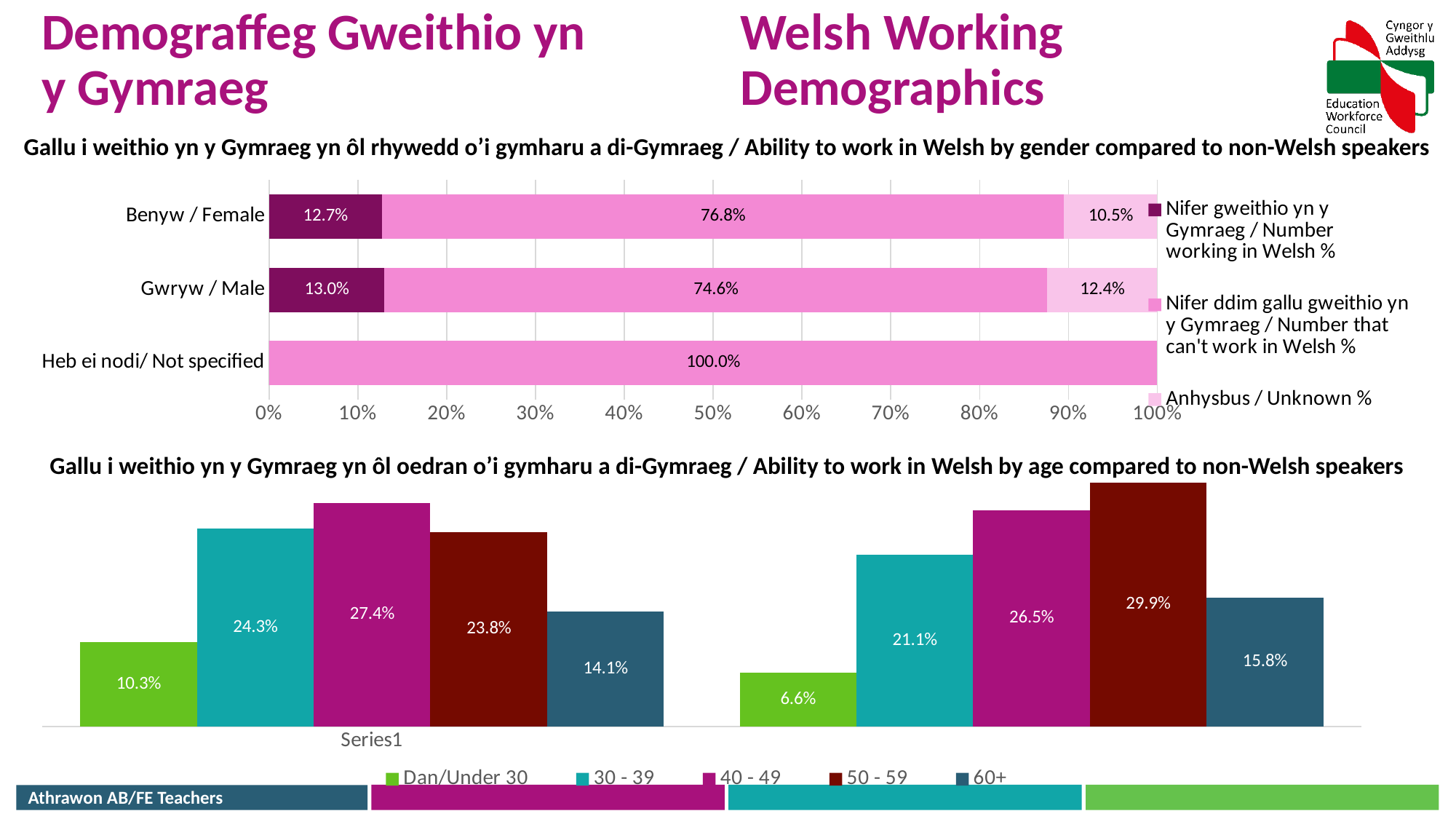
In the top chart (Ability to work in Welsh by gender), what is the 'Number that can't work in Welsh %' value for Gwryw / Male? 74.6% In the bottom chart (Ability to work in Welsh by age), what is the value for the 40 - 49 age group in Series1? 27.4% In the top chart (Ability to work in Welsh by gender), what is the difference between the Unknown % values for Gwryw / Male (12.4%) and Benyw / Female (10.5%)? 1.9 percentage points In the top chart (Ability to work in Welsh by gender), what percentage of Benyw / Female are shown as working in Welsh? 12.7% In the bottom chart (Ability to work in Welsh by age), which age group has the highest value in Series1? 40 - 49 In the top chart (Ability to work in Welsh by gender), what value is shown for Heb ei nodi / Not specified? 100.0% How many age groups does the legend of the bottom chart (Ability to work in Welsh by age) list? 5 In the top chart (Ability to work in Welsh by gender), which has the larger Anhysbus / Unknown % value, Benyw / Female or Gwryw / Male? Gwryw / Male In the bottom chart (Ability to work in Welsh by age), what is the difference between the 30 - 39 value (24.3%) and the 50 - 59 value (23.8%) in Series1? 0.5 percentage points How many series does the legend of the top chart (Ability to work in Welsh by gender) list? 3 In the bottom chart (Ability to work in Welsh by age), which age group has the lowest value in Series1? Dan/Under 30 What kind of chart is the top chart (Ability to work in Welsh by gender)? Stacked bar chart